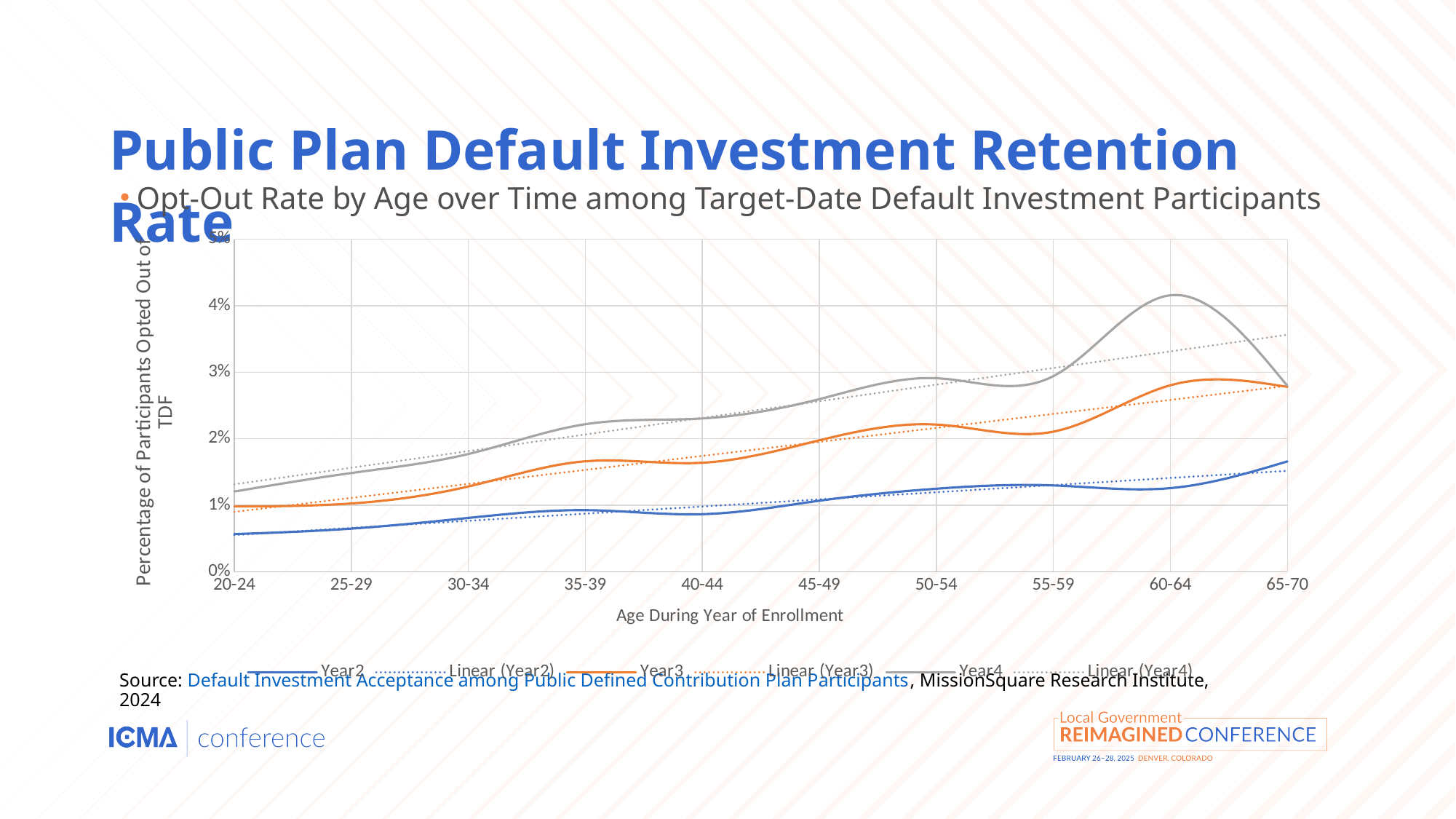
At 60-64, which is larger: the Year4 value or the Year2 value? Year4 How many age groups are shown along the x axis? 10 What kind of chart is shown on the slide? line chart How many entries does the legend list? 6 For the Year4 series, which age group has the highest opt-out rate? 60-64 Is the Year4 value for 60-64 greater or less than 3%? greater What is the title of the x axis? Age During Year of Enrollment Is the Year3 value for 40-44 greater or less than 2%? less Is the Year2 value for 20-24 greater or less than 1%? less Which series has the lowest opt-out rates across the age groups? Year2 Does the Year2 opt-out rate generally rise or fall from 20-24 to 65-70? rise Which series reaches the highest opt-out rate on the chart? Year4